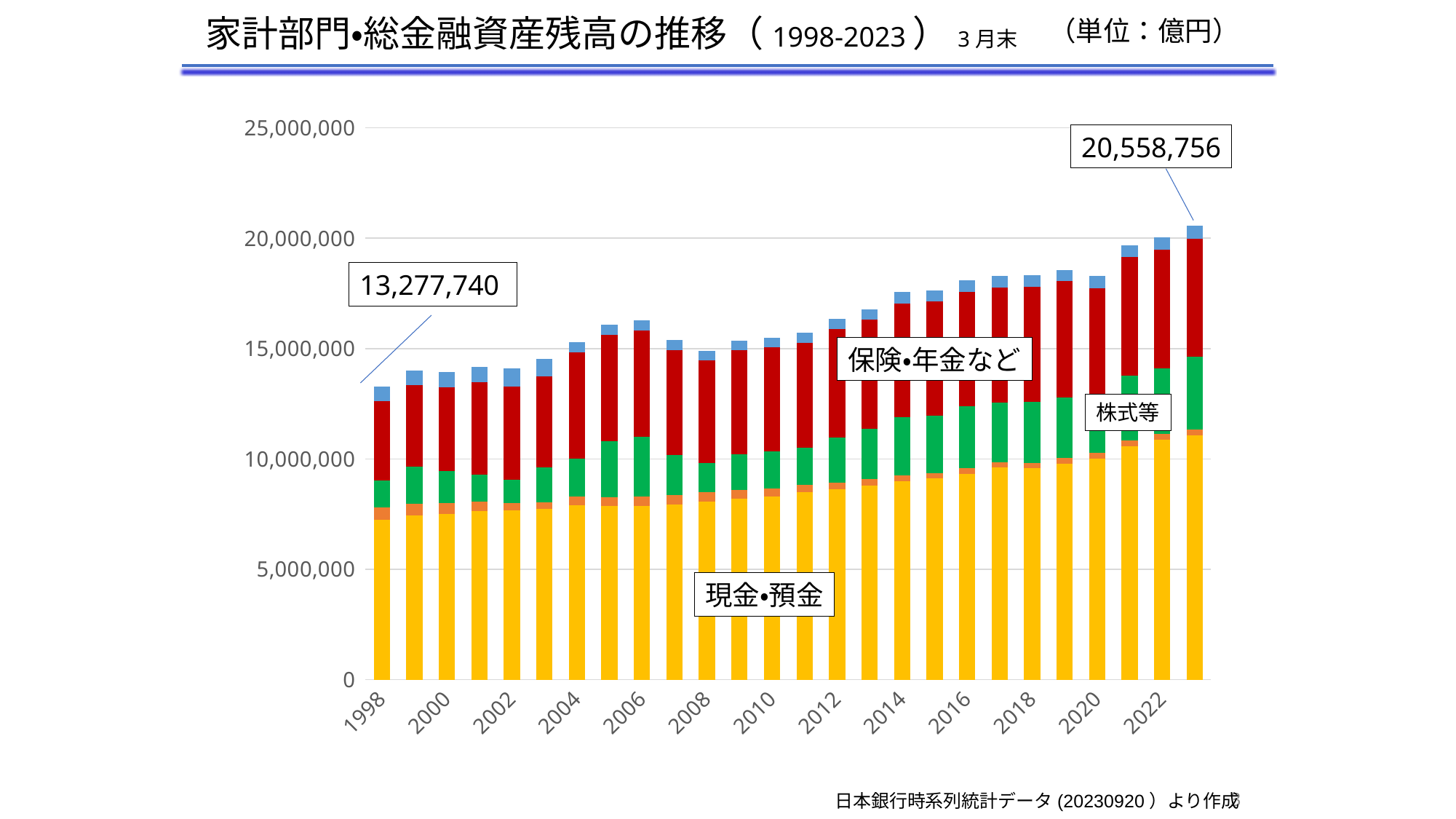
Do the total financial asset balances generally rise or fall from 1998 to 2023? Rise What unit is stated for the values on the chart? 億円 What is the total household financial asset balance shown for 1998? 13,277,740 Is the total for 2012 greater or less than 15,000,000? greater Is the total for 2020 greater or less than 20,000,000? less What kind of chart is shown on the slide? Stacked bar chart How many years (bars) are plotted on the chart? 26 What is the difference between the 2023 total (20,558,756) and the 1998 total (13,277,740)? 7,281,016 Which year has the highest total financial asset balance? 2023 What is the total household financial asset balance shown for 2023? 20,558,756 Which year has the lowest total financial asset balance? 1998 Which year has the larger total balance, 2005 or 2009? 2005